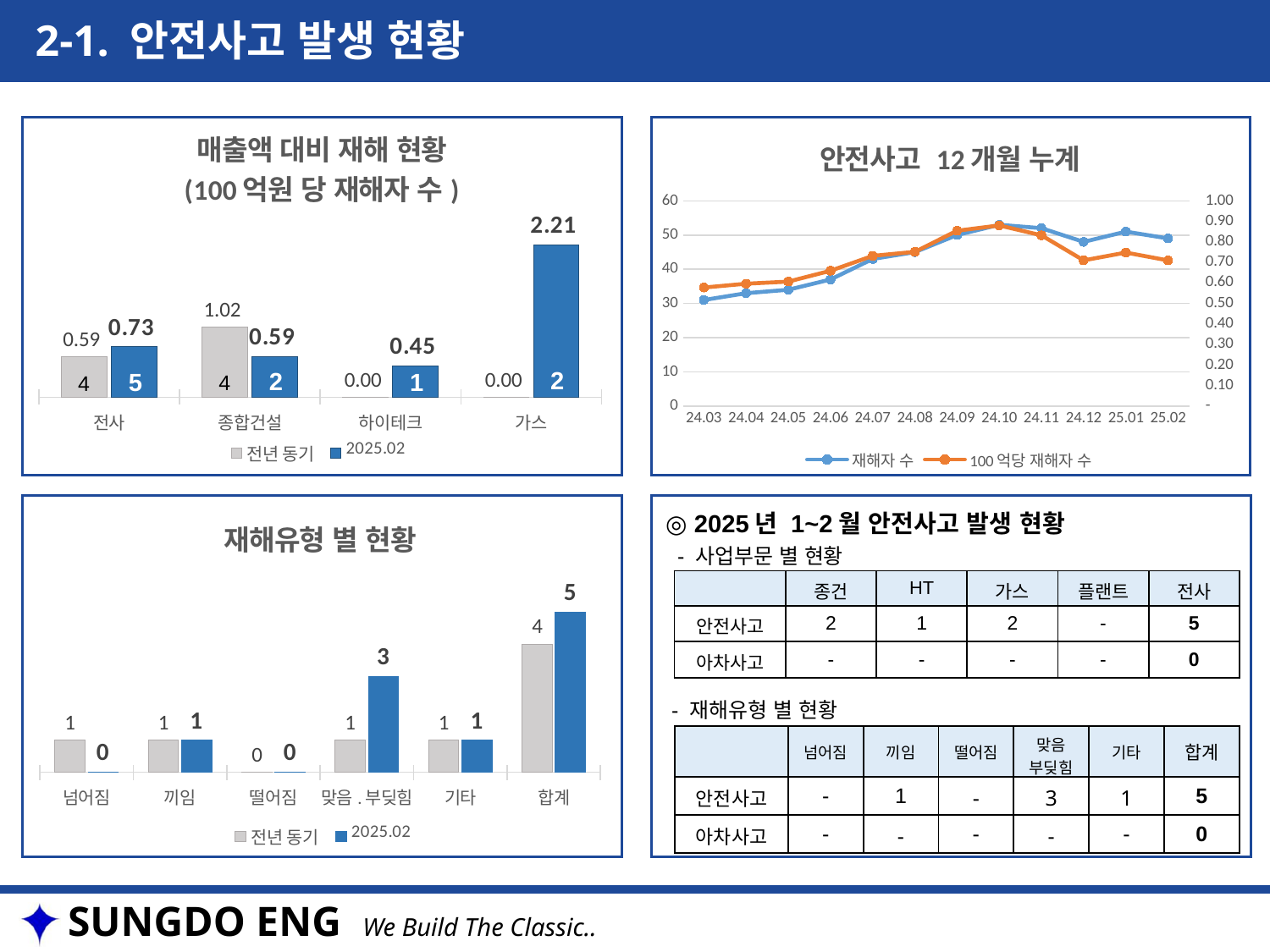
What kind of chart is the one titled '안전사고 12개월 누계'? line chart In the chart titled '매출액 대비 재해 현황', what is the 2025.02 value for 가스? 2.21 In the chart titled '매출액 대비 재해 현황', what is the difference between the 2025.02 value and the 전년 동기 value for 전사? 0.14 In the chart titled '매출액 대비 재해 현황', what is the 전년 동기 value for 종합건설? 1.02 In the chart titled '안전사고 12개월 누계', does the 재해자 수 series rise or fall from 24.03 to 24.10? rise In the chart titled '안전사고 12개월 누계', is the 재해자 수 value at 24.03 greater or less than 40? less In the chart titled '재해유형 별 현황', which category has the highest 2025.02 value? 합계 In the chart titled '매출액 대비 재해 현황', which category has the highest 2025.02 value? 가스 In the chart titled '재해유형 별 현황', is the 전년 동기 value for 넘어짐 larger or smaller than the 2025.02 value for 넘어짐? larger In the chart titled '매출액 대비 재해 현황', how many series does the legend list? 2 In the chart titled '재해유형 별 현황', how many categories are shown on the x axis? 6 In the chart titled '재해유형 별 현황', what is the 2025.02 value for 맞음.부딪힘? 3